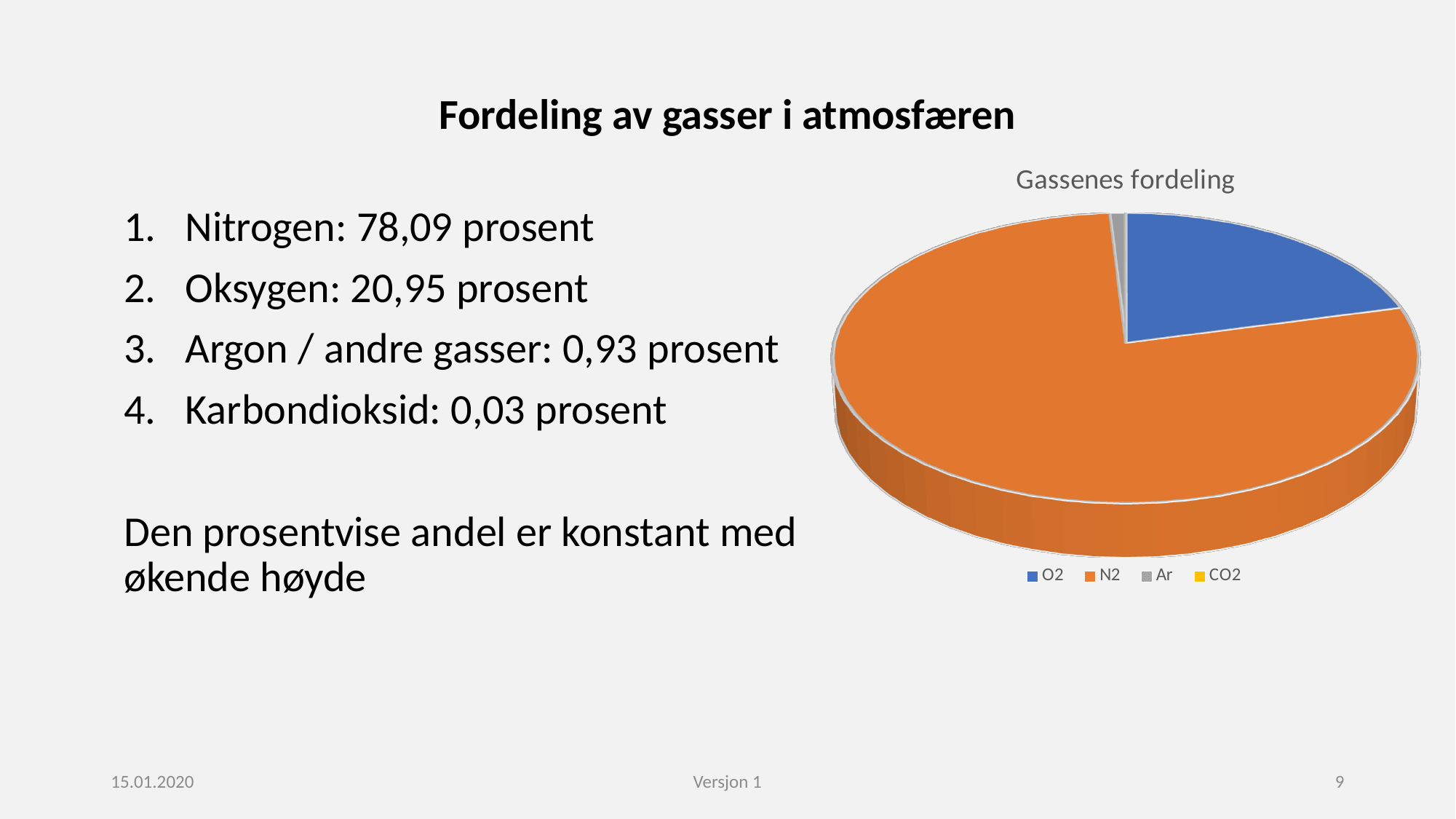
Which slice is larger, O2 or Ar? O2 Which gas has the largest slice in the pie chart? N2 What is the title of the chart? Gassenes fordeling According to the slide, what share of the atmosphere is nitrogen (N2)? 78,09 prosent According to the slide, what share of the atmosphere is carbon dioxide (CO2)? 0,03 prosent Which gas has the smallest slice in the pie chart? CO2 What kind of chart is shown on the slide? pie chart According to the slide, what share of the atmosphere is oxygen (O2)? 20,95 prosent What colour is the N2 slice in the pie chart? orange How many gases does the chart's legend list? 4 Which slice is larger, N2 or O2? N2